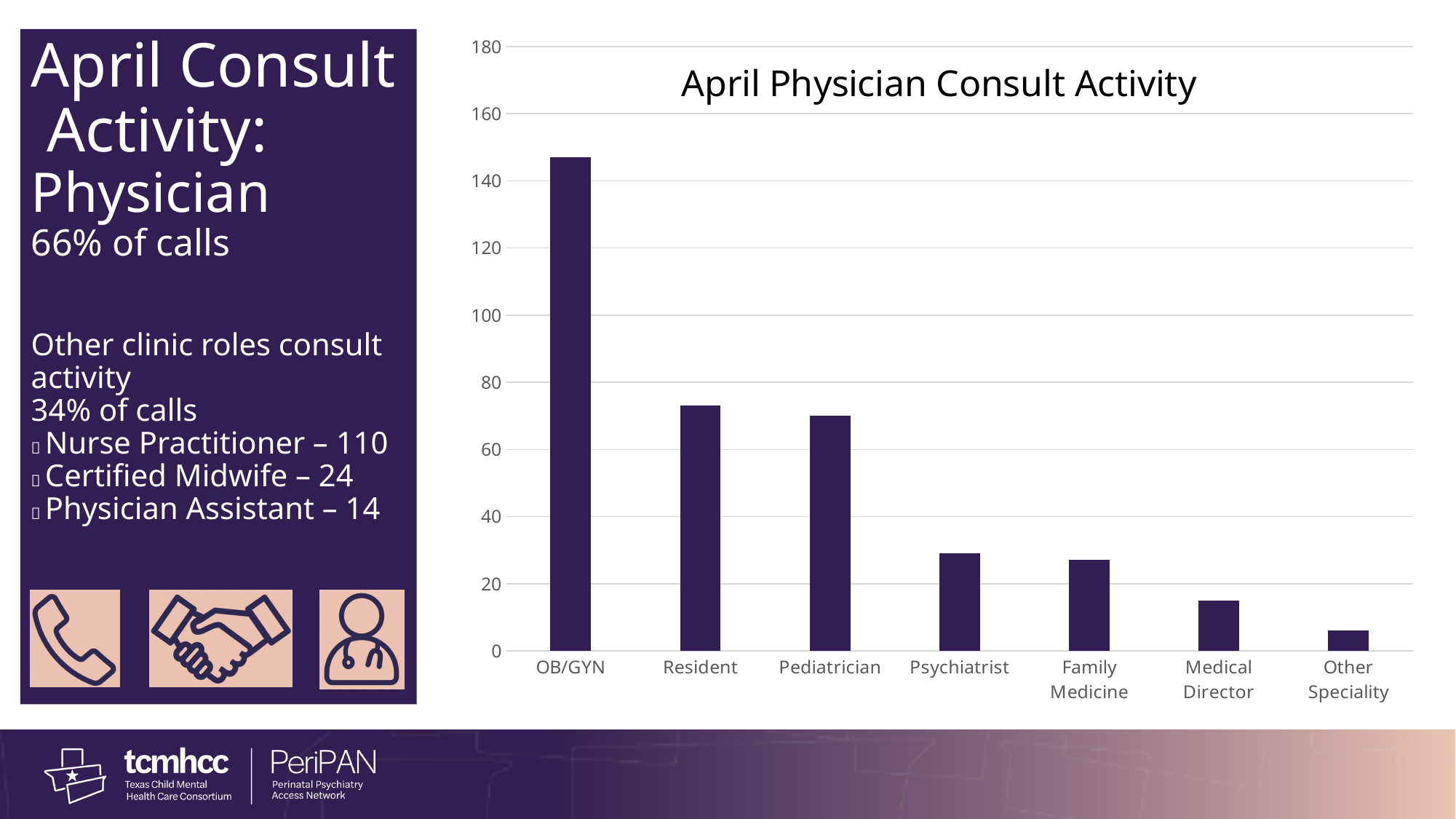
Is the value for Medical Director greater or less than 20? less Is the value for Resident greater or less than 80? less Is the value for OB/GYN greater or less than 140? greater What kind of chart is shown on the slide? bar chart Which category has the lowest value in the chart? Other Speciality Which category has the highest value in the chart? OB/GYN What is the title of the chart? April Physician Consult Activity Which is larger, the value for OB/GYN or the value for Resident? OB/GYN Do the values generally rise or fall moving from left to right along the x axis? fall How many categories are shown on the x axis of the chart? 7